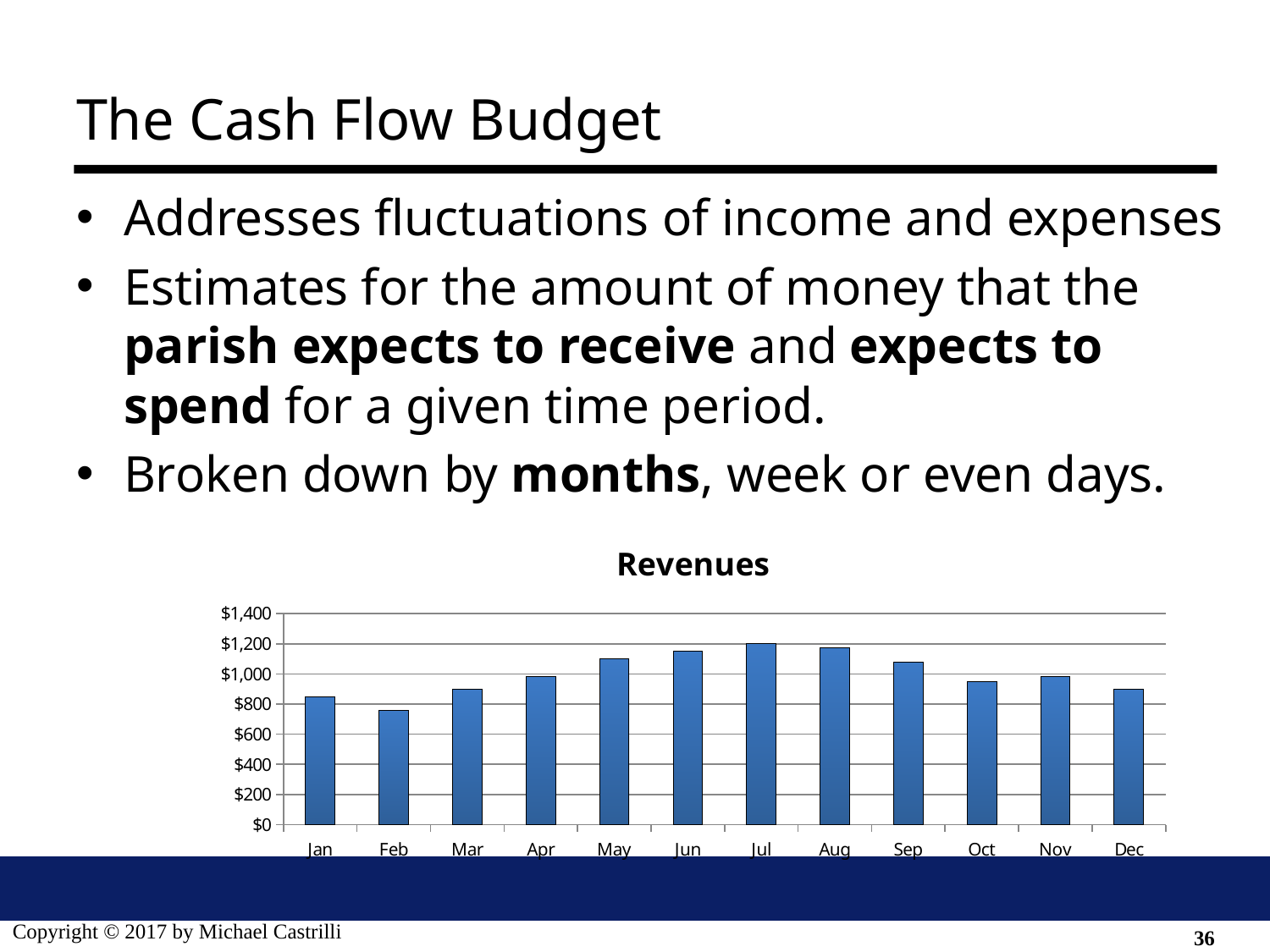
Is the value for Feb greater or less than $800? less What is the title of the chart? Revenues What kind of chart is shown on the slide? bar chart Is the value for Jul greater or less than $1,000? greater Which month has the highest revenue in the chart? Jul Do revenues generally rise or fall from Jan to Jul? rise How many months are shown on the x axis of the chart? 12 Is the value for Jan greater or less than $800? greater Which month has the lowest revenue in the chart? Feb Which is larger, the revenue for Jun or the revenue for Feb? Jun